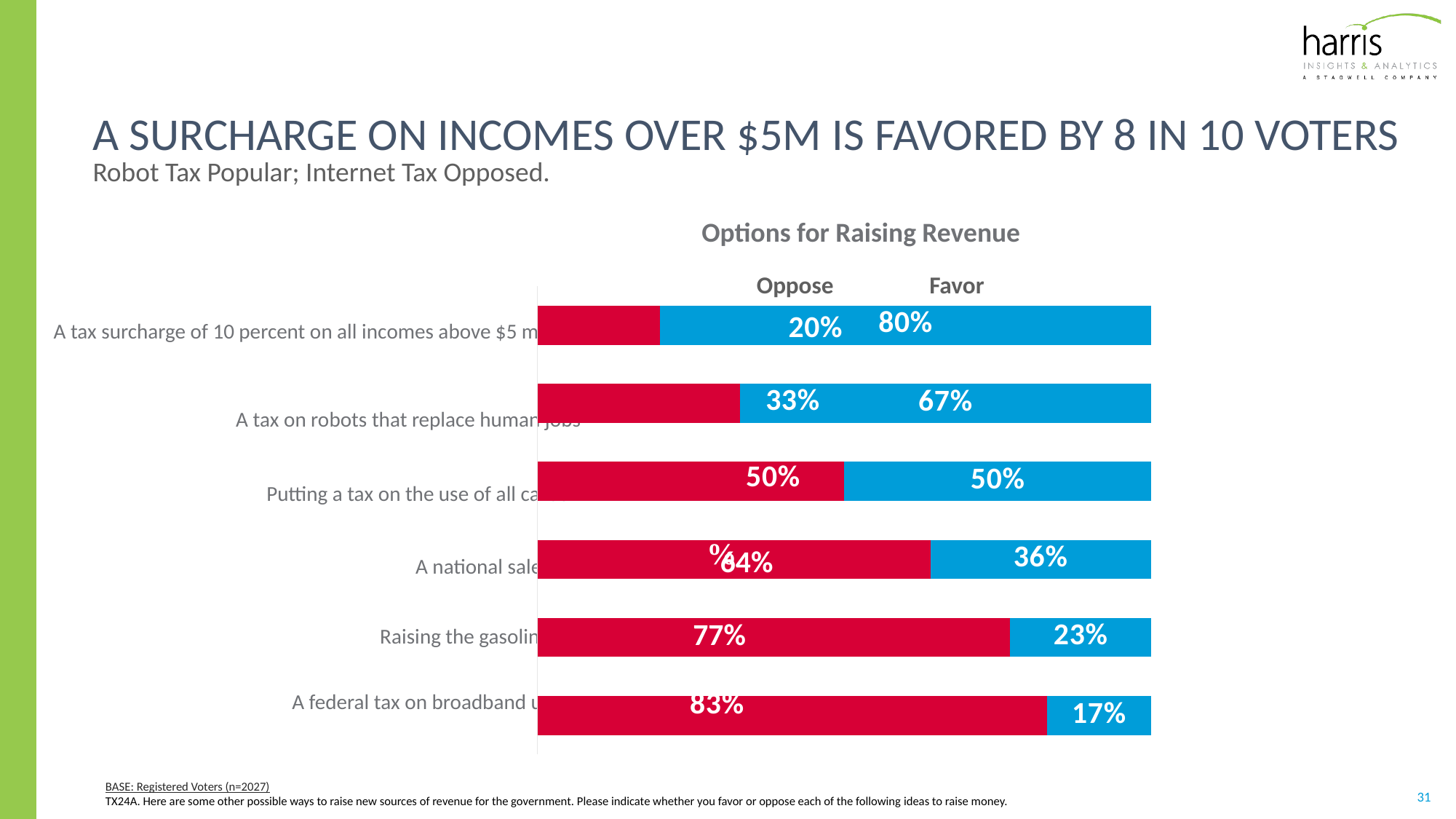
How many revenue options are listed in the chart? 6 What percentage of voters oppose a tax on robots that replace human jobs? 33% What are the two series shown in the chart? Oppose and Favor What percentage of voters favor a tax surcharge of 10 percent on all incomes above $5 million? 80% What percentage of voters oppose raising the gasoline tax? 77% What percentage of voters favor a federal tax on broadband use? 17% How many series does the chart show? 2 Which revenue option has the lowest Favor percentage? A federal tax on broadband use Which is larger for the national sales tax: the Oppose percentage or the Favor percentage? Oppose Which revenue option has the highest Favor percentage? A tax surcharge of 10 percent on all incomes above $5 million What kind of chart is shown under the title "Options for Raising Revenue"? bar chart What is the difference between the Favor and Oppose percentages for the tax on robots that replace human jobs? 34%